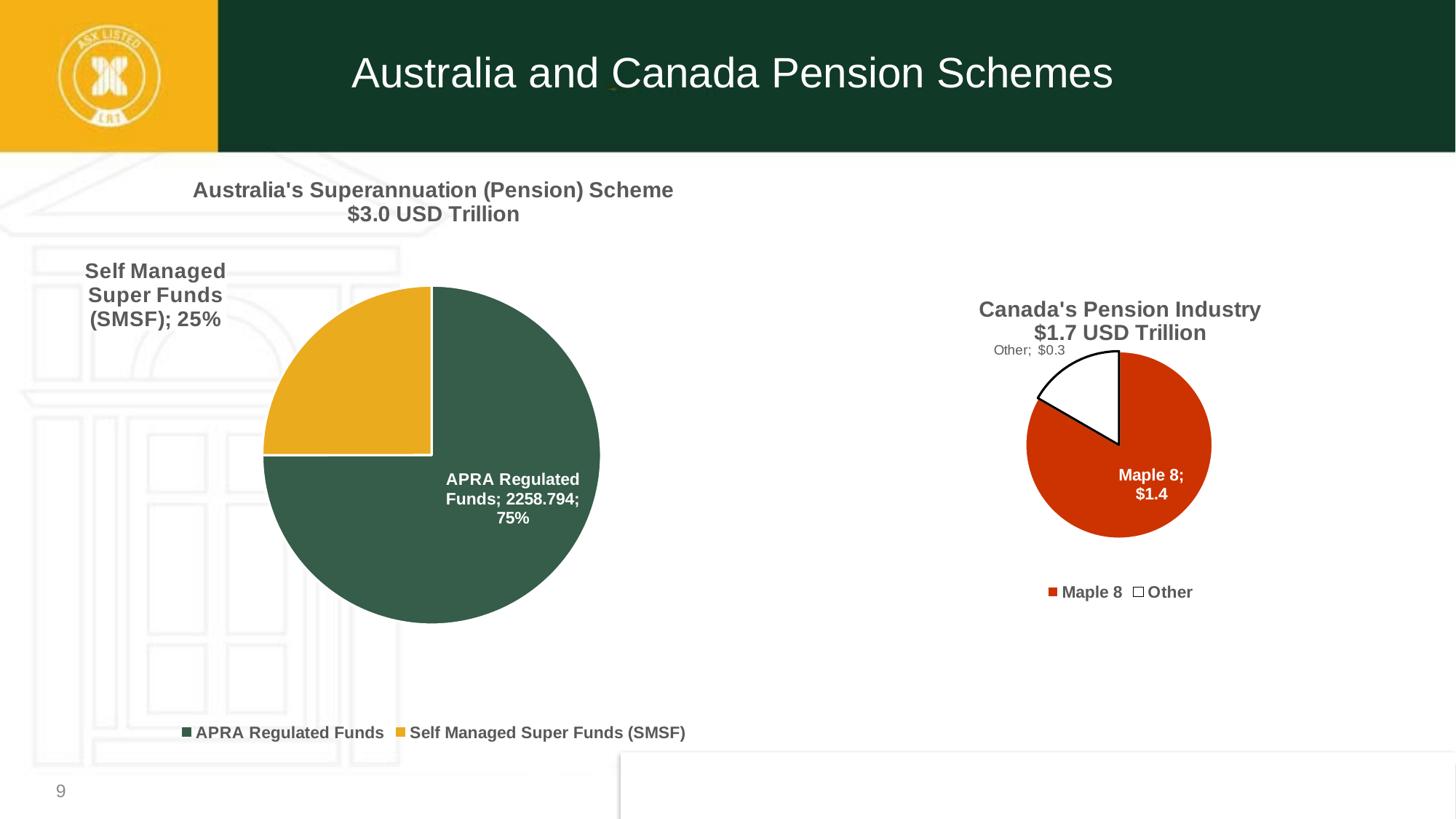
In the Australia's Superannuation (Pension) Scheme chart, which slice is the largest? APRA Regulated Funds In the Canada's Pension Industry chart, which slice is the smallest? Other In the Canada's Pension Industry chart, what value is printed for Maple 8? $1.4 In the Canada's Pension Industry chart, what is the difference between the Maple 8 value and the Other value? $1.1 In the Australia's Superannuation (Pension) Scheme chart, what share of the pie is APRA Regulated Funds? 75% In the Australia's Superannuation (Pension) Scheme chart, what share of the pie is Self Managed Super Funds (SMSF)? 25% In the Canada's Pension Industry chart, which is larger, Maple 8 or Other? Maple 8 In the Canada's Pension Industry chart, what value is printed for Other? $0.3 What kind of chart is the Australia's Superannuation (Pension) Scheme chart? Pie chart What total is stated in the title of the Australia's Superannuation (Pension) Scheme chart? $3.0 USD Trillion How many slices does the Canada's Pension Industry pie chart have? 2 In the Australia's Superannuation (Pension) Scheme chart, what value is printed for APRA Regulated Funds? 2258.794